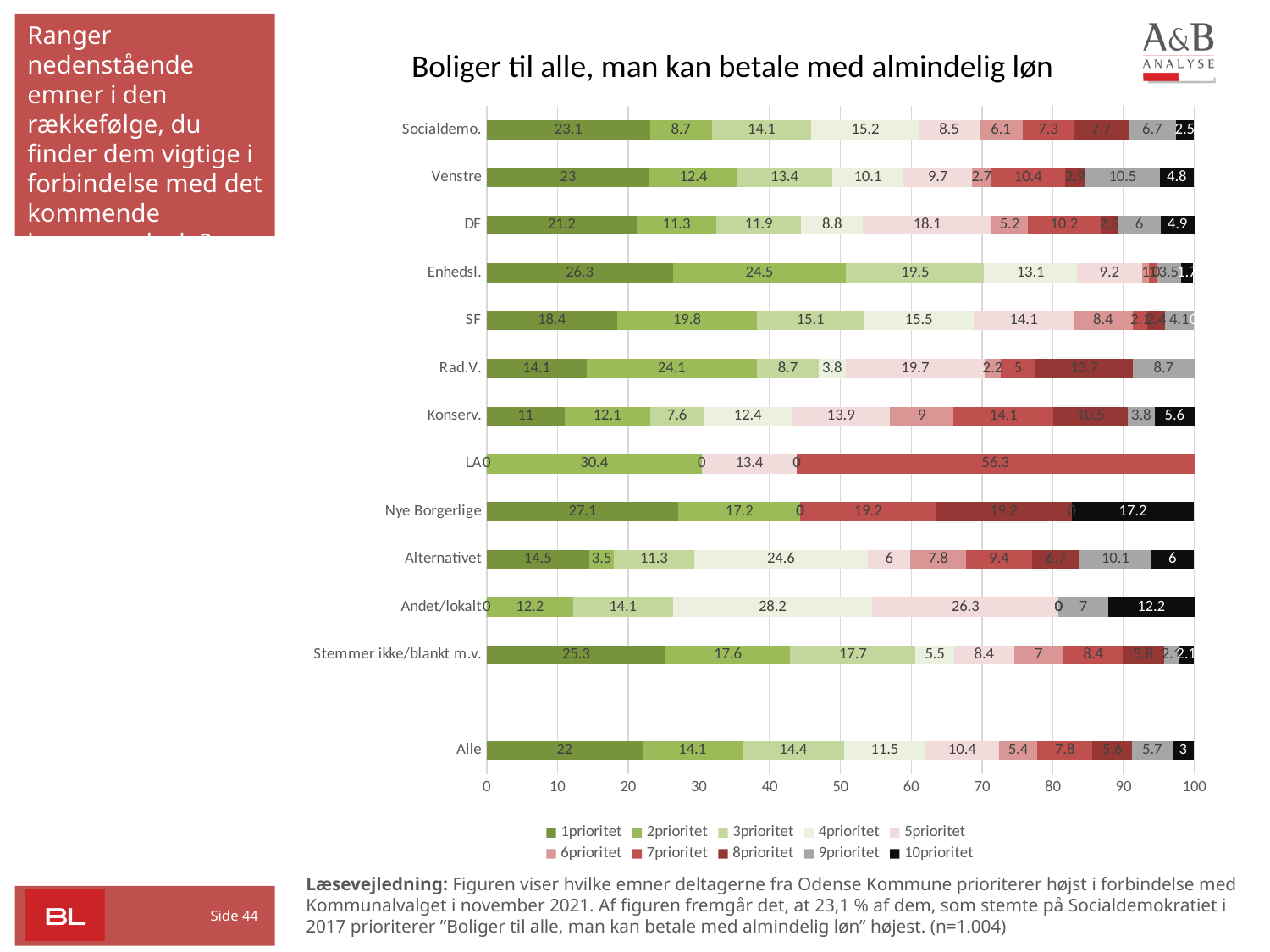
Which has the larger 1prioritet value, Enhedsl. or DF? Enhedsl. What is the 1prioritet value for Alle? 22 What is the 1prioritet value for Socialdemo.? 23.1 How many categories are shown on the y axis of the chart? 13 What is the 7prioritet value for LA? 56.3 What is the title of the chart? Boliger til alle, man kan betale med almindelig løn What is the 4prioritet value for Andet/lokalt? 28.2 What is the difference between the 1prioritet value for Alle and the 2prioritet value for Alle? 7.9 Which category has the highest 1prioritet value? Nye Borgerlige What kind of chart is shown on the slide? Stacked bar chart What is the 10prioritet value for Nye Borgerlige? 17.2 How many series does the legend list? 10